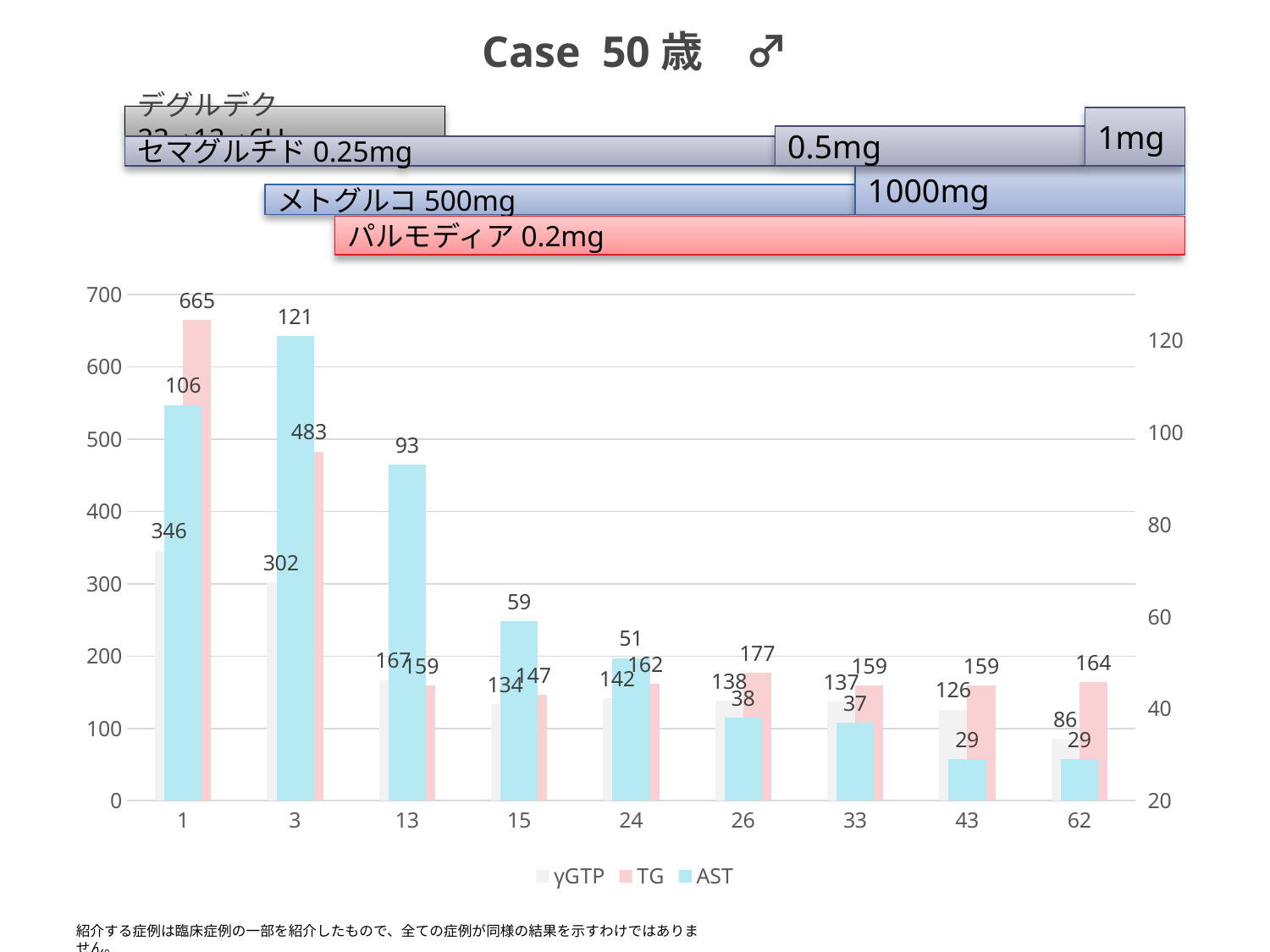
What is the AST value at x = 3? 121 Which series is shown in light blue in the legend? AST How many x-axis categories does the chart show? 9 What is the TG value at x = 1? 665 What is the γGTP value at x = 62? 86 At which x-axis category is the γGTP value lowest? 62 Does the AST value generally rise or fall from x = 1 to x = 62? fall Which is larger at x = 13, the γGTP value or the TG value? γGTP How many series does the legend list? 3 What is the difference between the γGTP values at x = 1 and x = 3? 44 What kind of chart is shown on the slide? bar chart At which x-axis category is the TG value highest? 1